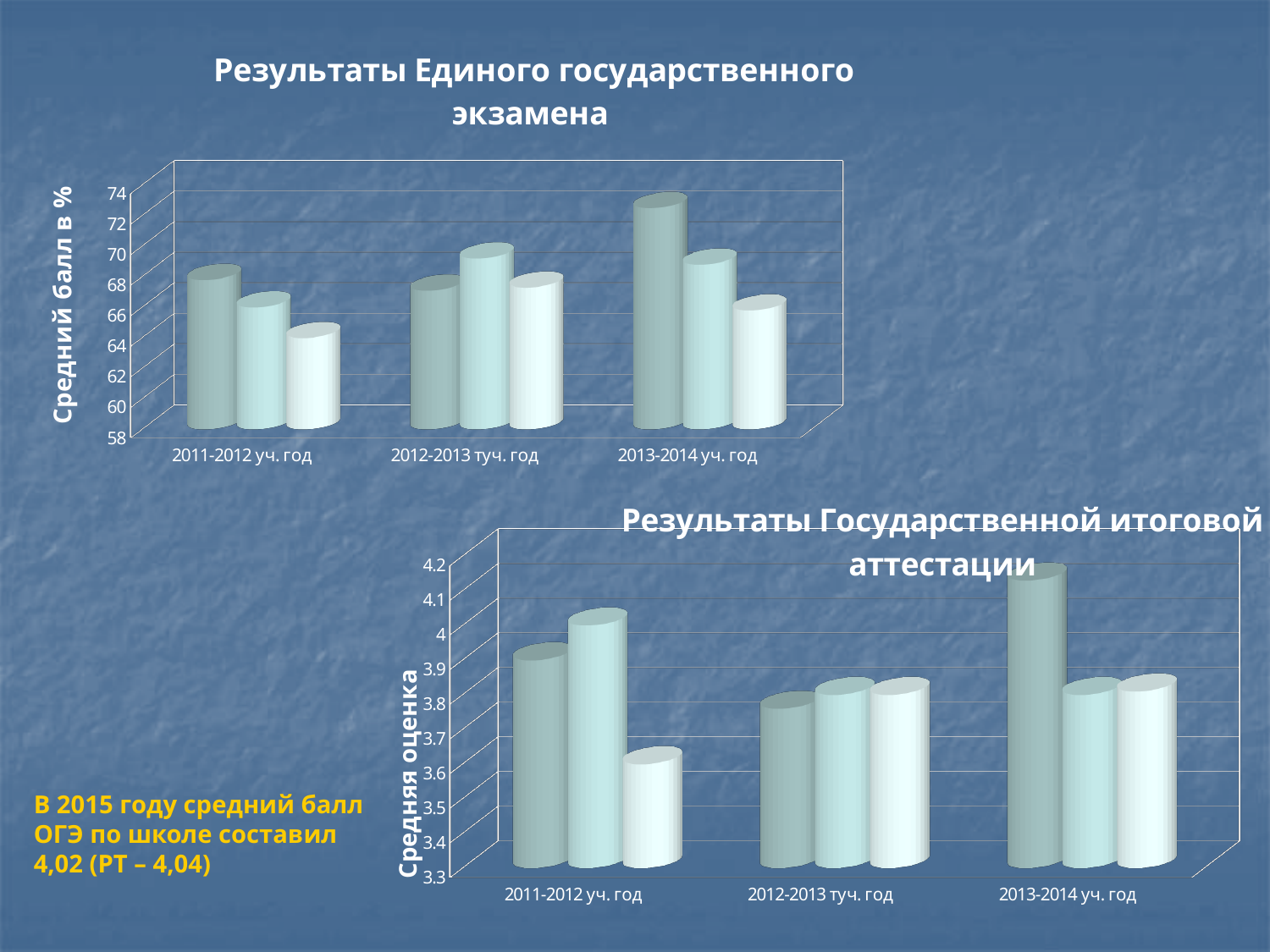
In the top chart, which academic year contains the tallest bar? 2013-2014 уч. год What type of chart is the top chart titled 'Результаты Единого государственного экзамена'? bar chart In the top chart, is the value of the first (leftmost) bar for 2013-2014 уч. год greater or less than 70? greater What type of chart is the bottom chart titled 'Результаты Государственной итоговой аттестации'? bar chart What is the y-axis title of the top chart? Средний балл в % How many academic-year categories are shown on the x axis of the top chart? 3 In the bottom chart, is the value of the first (leftmost) bar for 2013-2014 уч. год greater or less than 4? greater In the top chart, is the value of the third (rightmost) bar for 2011-2012 уч. год greater or less than 66? less What is the y-axis title of the bottom chart? Средняя оценка In the bottom chart, which academic year contains the shortest bar? 2011-2012 уч. год How many academic-year categories are shown on the x axis of the bottom chart? 3